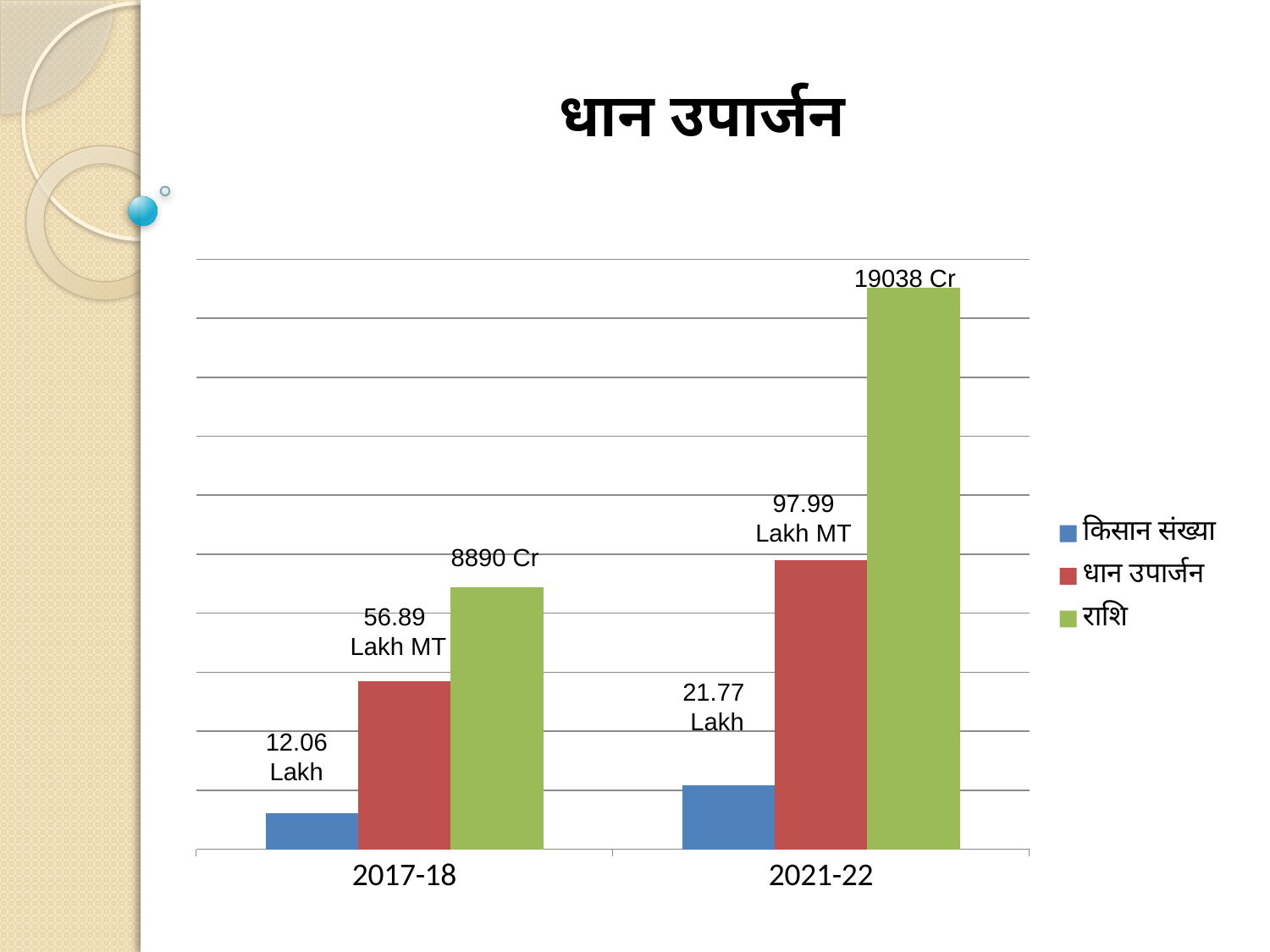
What is the title of the chart on the slide? धान उपार्जन What is the value of किसान संख्या for 2021-22? 21.77 Lakh Which year has the higher value for किसान संख्या, 2017-18 or 2021-22? 2021-22 What is the value of राशि for 2021-22? 19038 Cr What is the value of राशि for 2017-18? 8890 Cr How many series does the legend list? 3 What type of chart is shown on the slide? Bar chart Do the values for राशि rise or fall from 2017-18 to 2021-22? Rise What is the value of धान उपार्जन for 2017-18? 56.89 Lakh MT What is the difference in राशि between 2021-22 and 2017-18? 10148 Cr How many categories are shown on the x axis? 2 What is the difference in धान उपार्जन between 2021-22 and 2017-18? 41.10 Lakh MT